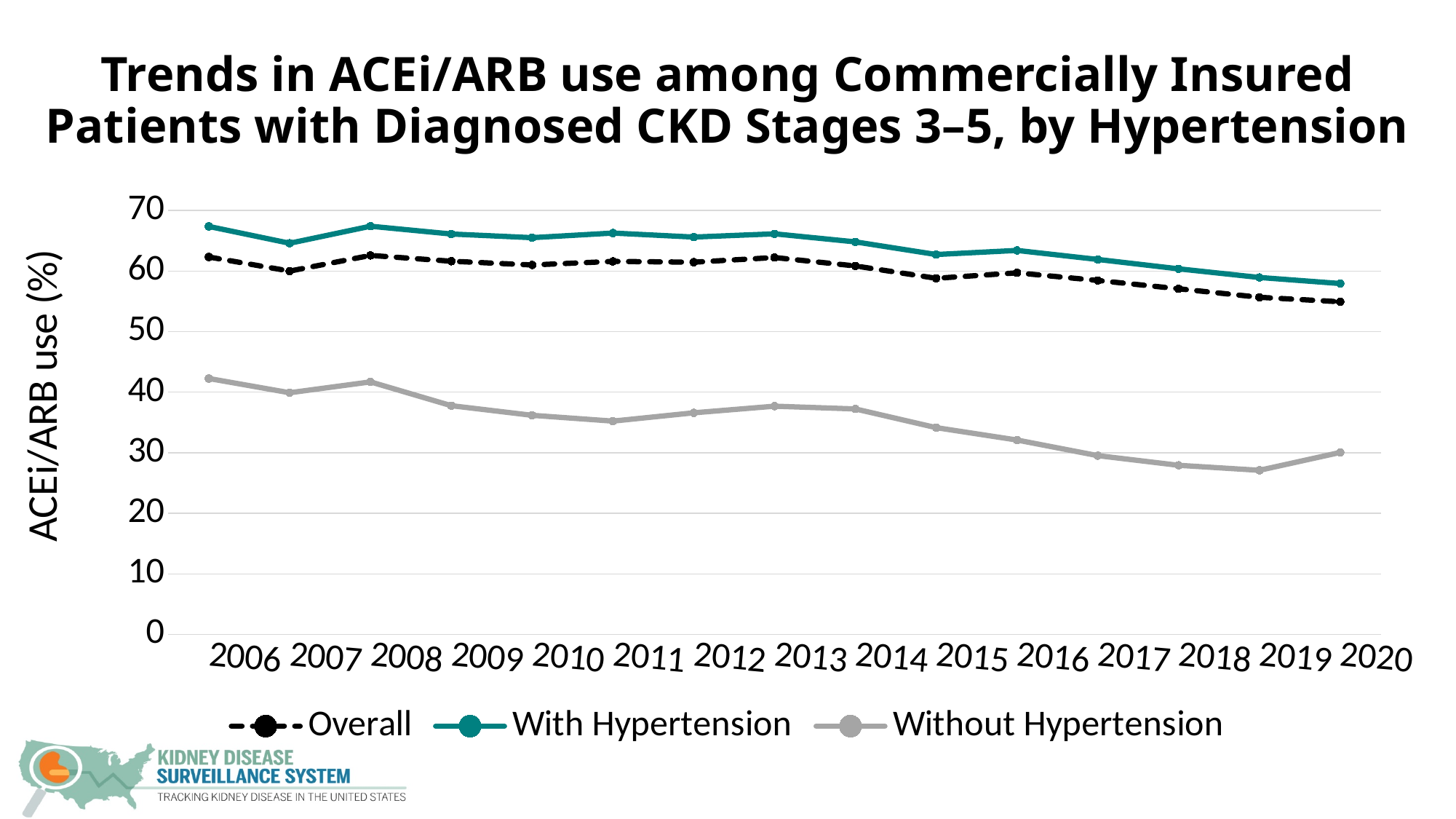
Which series has the highest value in 2015? With Hypertension Which series has the lowest values across all years shown? Without Hypertension Is the value for Without Hypertension in 2019 greater or less than 30? less In 2010, which is larger: the value for With Hypertension or the value for Without Hypertension? With Hypertension What is the label on the y axis? ACEi/ARB use (%) How many series does the legend list? 3 Is the value for Overall in 2020 greater or less than 60? less Is the value for With Hypertension in 2006 greater or less than 60? greater Does the With Hypertension series generally rise or fall from 2006 to 2020? fall How many years are plotted along the x axis? 15 What kind of chart is shown on the slide? line chart